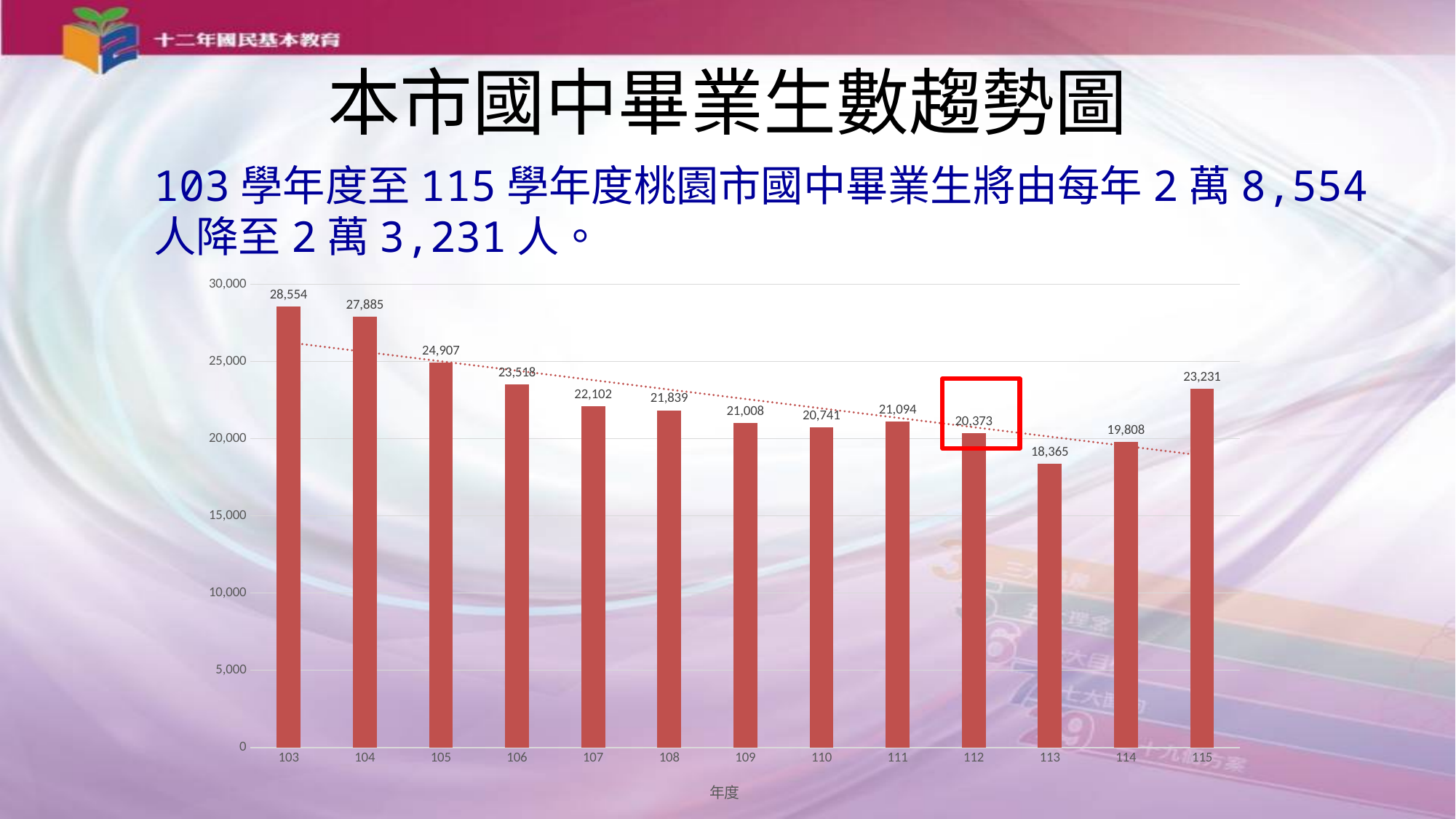
What kind of chart is shown on the slide? bar chart What is the value for year 112, the bar highlighted with a red box? 20,373 What is the value for year 113? 18,365 Which year has the highest value? 103 Is the value for year 114 greater or less than 20,000? less Which is larger, the value for year 110 or the value for year 111? 111 Which year has the lowest value? 113 How many years are shown on the x axis? 13 What is the label of the x axis? 年度 What is the difference between the values for year 103 and year 115? 5,323 What is the value for year 103? 28,554 What is the value for year 115? 23,231